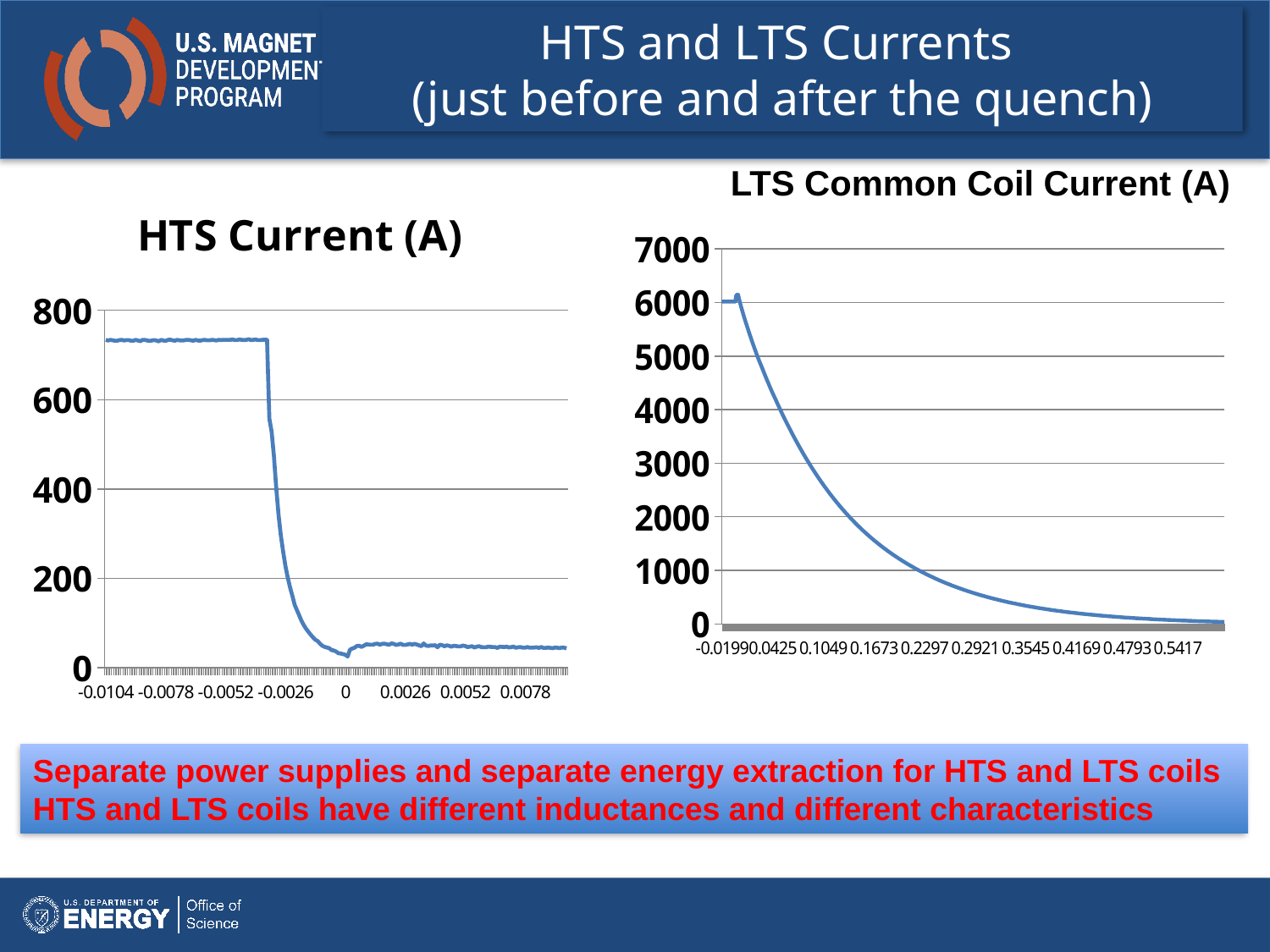
In the LTS Common Coil Current (A) chart, is the value at x = 0.4169 greater or less than 1000? less In the LTS Common Coil Current (A) chart, is the value at x = 0.0425 greater or less than 4000? greater What is the title of the chart on the left side of the slide? HTS Current (A) In the HTS Current (A) chart, is the value at x = -0.0078 greater or less than 600? greater What is the highest tick value on the y axis of the LTS Common Coil Current (A) chart? 7000 How many charts are shown on the slide? 2 What kind of chart is the HTS Current (A) chart? line chart In the HTS Current (A) chart, does the current rise or fall as x moves from -0.0026 to 0? fall How many lines are plotted in the HTS Current (A) chart? 1 In the LTS Common Coil Current (A) chart, do the values rise or fall as x increases? fall What kind of chart is the LTS Common Coil Current (A) chart? line chart